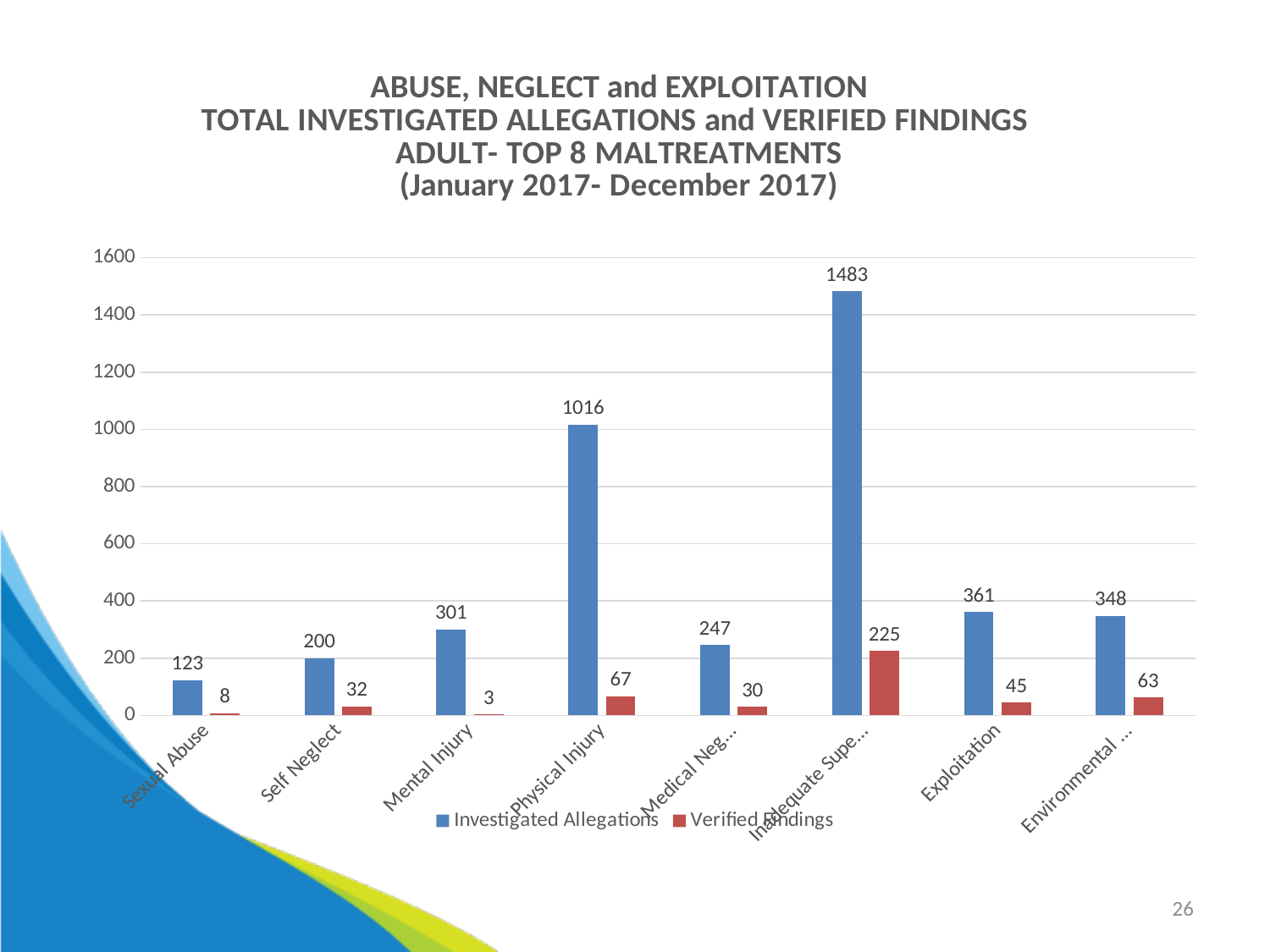
What is the difference between Investigated Allegations and Verified Findings for Sexual Abuse? 115 Which category has the highest number of Investigated Allegations? Inadequate Supe... What is the number of Investigated Allegations for Physical Injury? 1016 Which category has the lowest number of Verified Findings? Mental Injury Which series is shown in red in the legend? Verified Findings Which has more Investigated Allegations, Exploitation or Mental Injury? Exploitation How many series does the legend list? 2 What is the number of Verified Findings for Self Neglect? 32 What is the number of Investigated Allegations for Exploitation? 361 What kind of chart is shown on the slide? Bar chart How many maltreatment categories are plotted on the x axis? 8 Is the value of Investigated Allegations for Physical Injury greater or less than 1000? greater